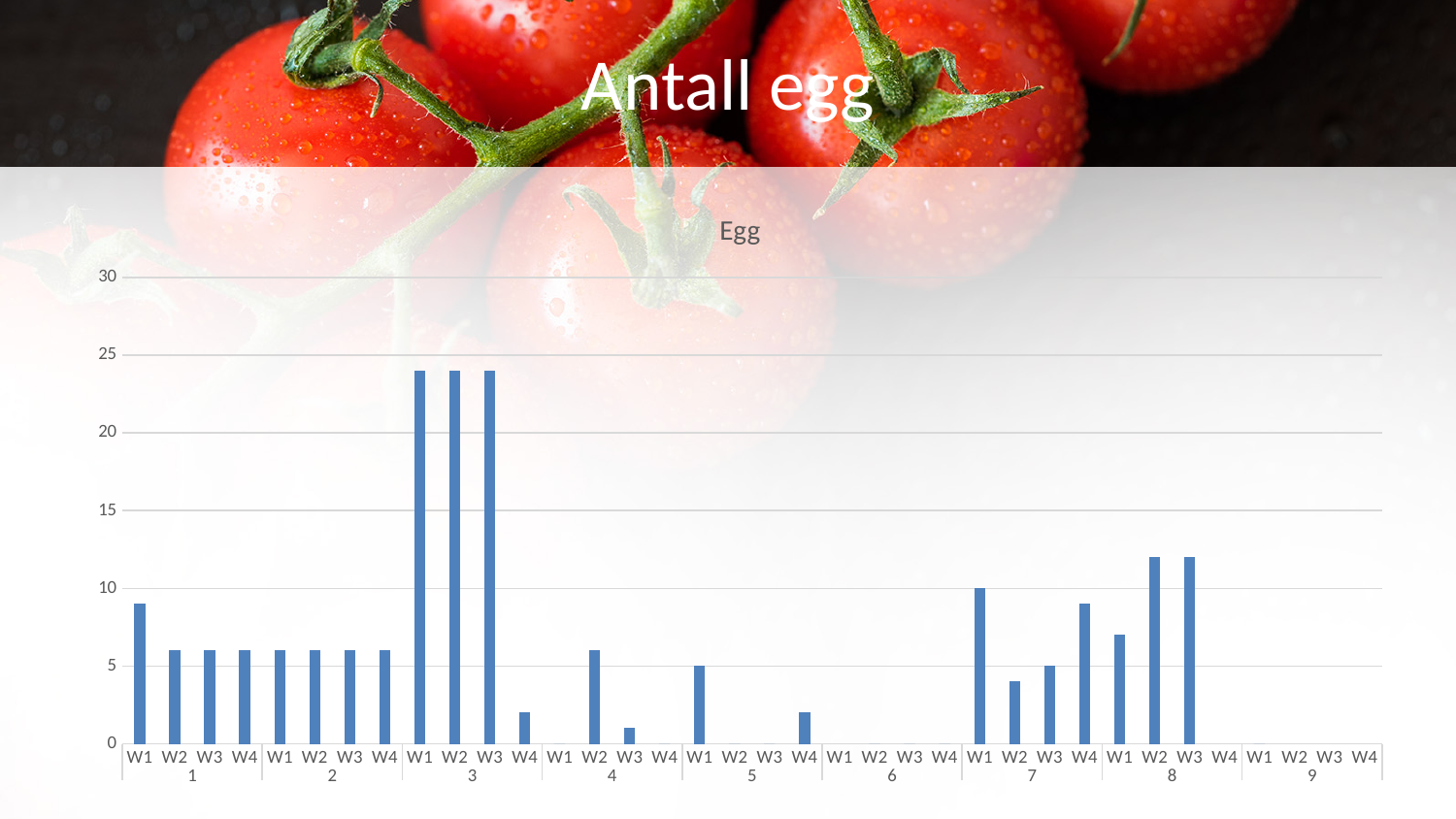
Which month group shows no bars at all for any of its weeks? 6 and 9 Is the value for W2 in month 8 greater or less than 10? greater What is the title of the chart? Egg Is the value for W1 in month 1 greater or less than 10? less Which is larger, the value for W1 in month 1 or the value for W2 in month 1? W1 in month 1 What kind of chart is shown on the slide? bar chart How many month groups (1 to 9) are shown along the x axis? 9 Which is larger, the value for W2 in month 8 or the value for W2 in month 7? W2 in month 8 How many week categories (W1 to W4) are shown within each month group? 4 Is the value for W4 in month 3 greater or less than 5? less Which month group contains the tallest bars in the chart? 3